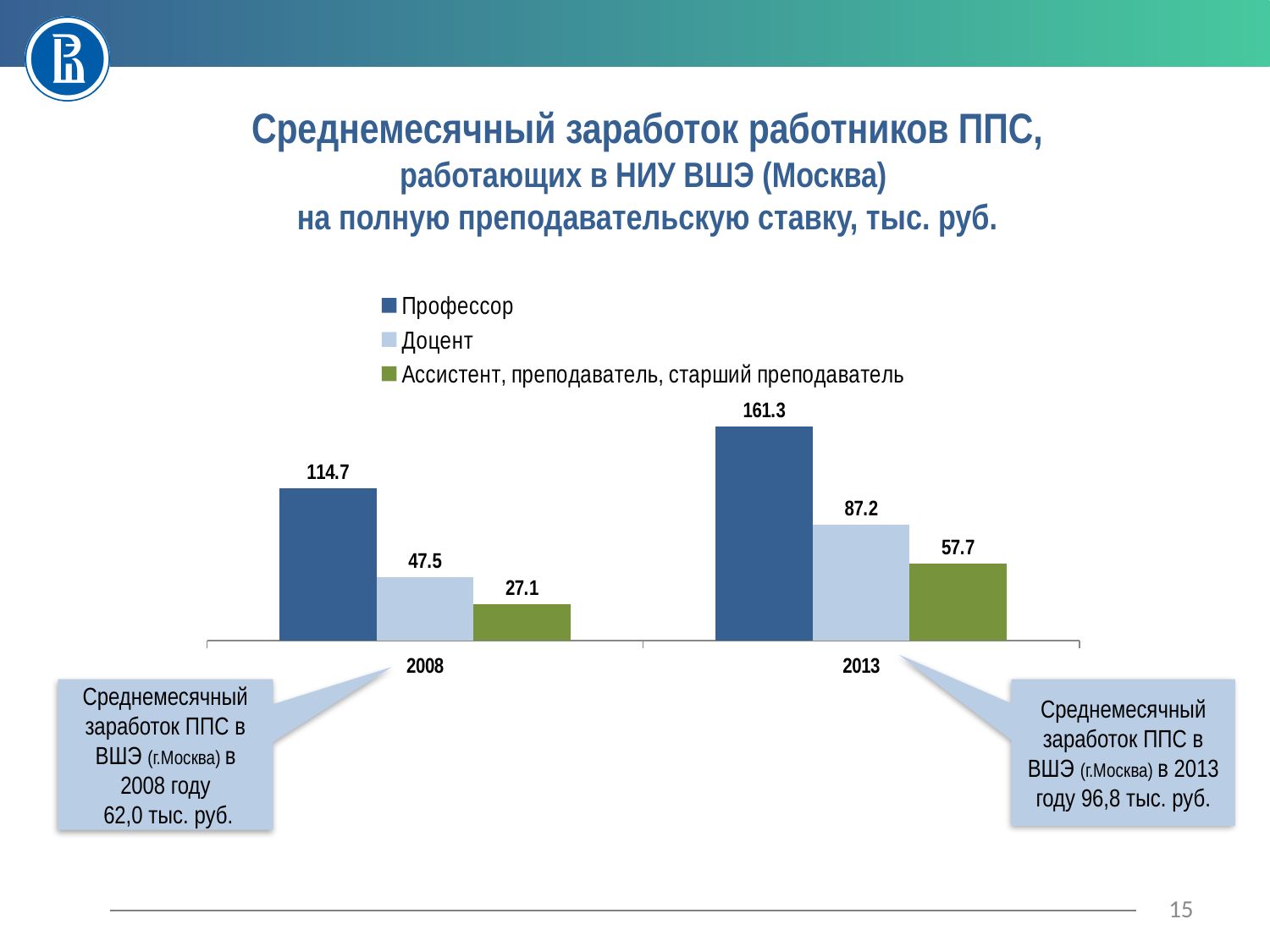
What is the difference between Доцент and Ассистент, преподаватель, старший преподаватель in 2013? 29.5 What is the value for Ассистент, преподаватель, старший преподаватель in 2008? 27.1 Does the value for Доцент rise or fall from 2008 to 2013? Rise How many series does the legend list? 3 Which series has the highest value in 2013? Профессор Which is larger: Доцент in 2013 or Профессор in 2008? Профессор in 2008 What is the value for Доцент in 2013? 87.2 How many year categories are shown on the x axis? 2 What is the difference between the Профессор values for 2013 and 2008? 46.6 What is the value for Профессор in 2008? 114.7 Which series has the lowest value in 2008? Ассистент, преподаватель, старший преподаватель What kind of chart is shown on the slide? Bar chart